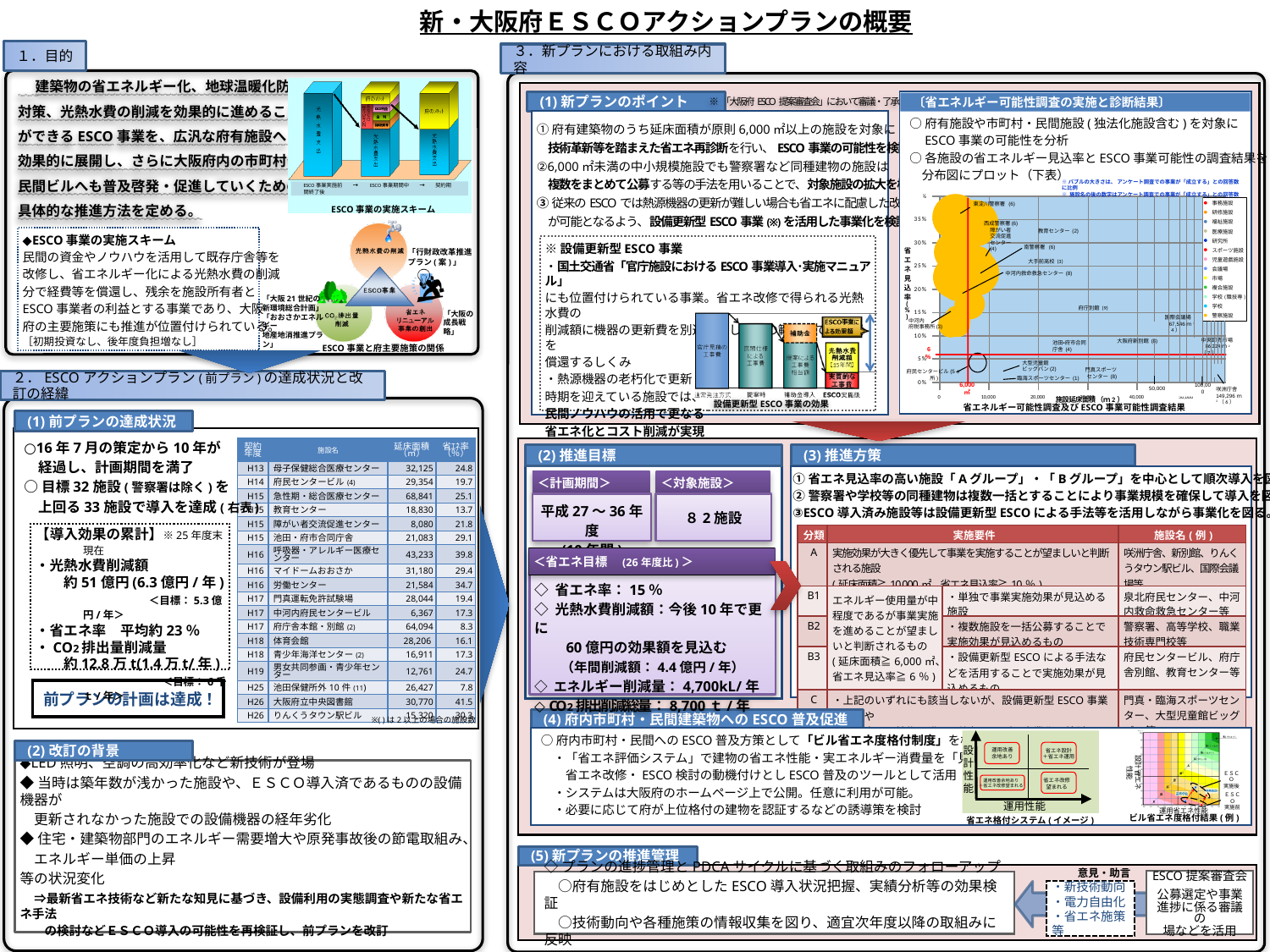
What kind of chart is the 省エネルギー可能性調査及びESCO事業可能性調査結果 chart? bubble chart In the 省エネルギー可能性調査及びESCO事業可能性調査結果 chart, is the 省エネ見込率 for 府庁別館 greater or less than 20%? less In the 省エネルギー可能性調査及びESCO事業可能性調査結果 chart, which facility has the largest floor area? 咲洲庁舎 In the 省エネルギー可能性調査及びESCO事業可能性調査結果 chart, is the 省エネ見込率 for 臨海スポーツセンター greater or less than 10%? less In the 省エネルギー可能性調査及びESCO事業可能性調査結果 chart, what is the label of the vertical axis? 省エネ見込率 (%) In the 省エネルギー可能性調査及びESCO事業可能性調査結果 chart, what floor area is printed for 咲洲庁舎? 149,296 m² In the 省エネルギー可能性調査及びESCO事業可能性調査結果 chart, which has the larger floor area, 咲洲庁舎 or 国際会議場? 咲洲庁舎 In the 省エネルギー可能性調査及びESCO事業可能性調査結果 chart, what is the difference in floor area between 咲洲庁舎 and 国際会議場? 81,700 m² In the 省エネルギー可能性調査及びESCO事業可能性調査結果 chart, what floor area is printed for 国際会議場? 67,596 m² In the 省エネルギー可能性調査及びESCO事業可能性調査結果 chart, what is the label of the horizontal axis? 施設延床面積 (m²) In the 省エネルギー可能性調査及びESCO事業可能性調査結果 chart, is the 省エネ見込率 for 東淀川警察署 greater or less than 30%? greater